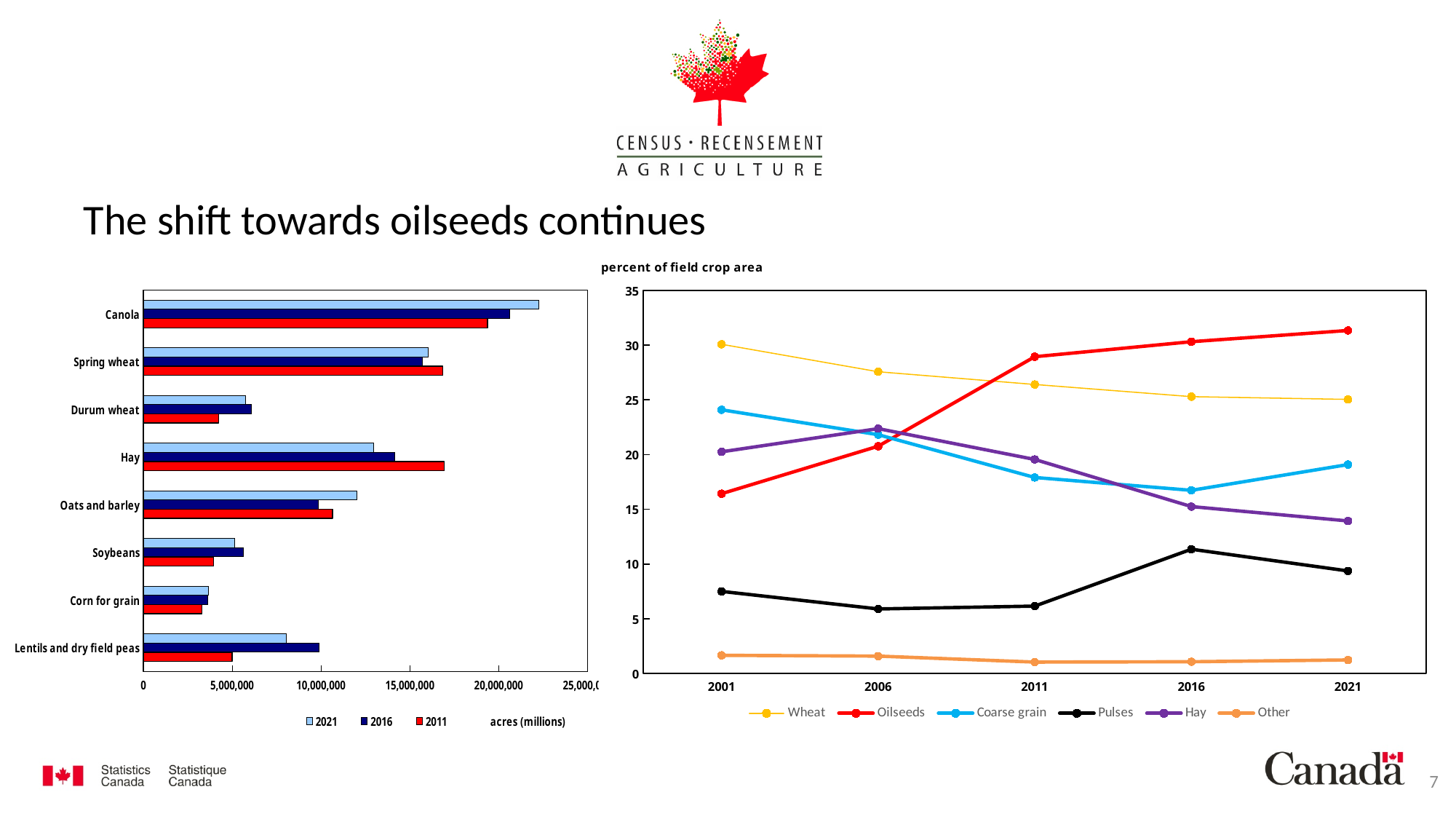
On the left bar chart, is the 2021 value for Canola greater or less than 20,000,000? greater What kind of chart is the chart on the left of the slide? bar chart On the 'percent of field crop area' line chart, which series has the highest value in 2021? Oilseeds On the left bar chart, which is larger for Lentils and dry field peas: the 2016 value or the 2021 value? 2016 How many crop categories are shown on the left bar chart? 8 On the 'percent of field crop area' line chart, does the Wheat series rise or fall from 2001 to 2021? fall How many series does the legend of the left bar chart list? 3 On the left bar chart, which crop has the smallest area in 2021? Corn for grain On the left bar chart, is the 2011 value for Hay greater or less than 15,000,000? greater On the left bar chart, which crop has the largest area in 2021? Canola On the 'percent of field crop area' line chart, is the value for Pulses in 2016 greater or less than 10? greater On the 'percent of field crop area' line chart, which series has the highest value in 2001? Wheat